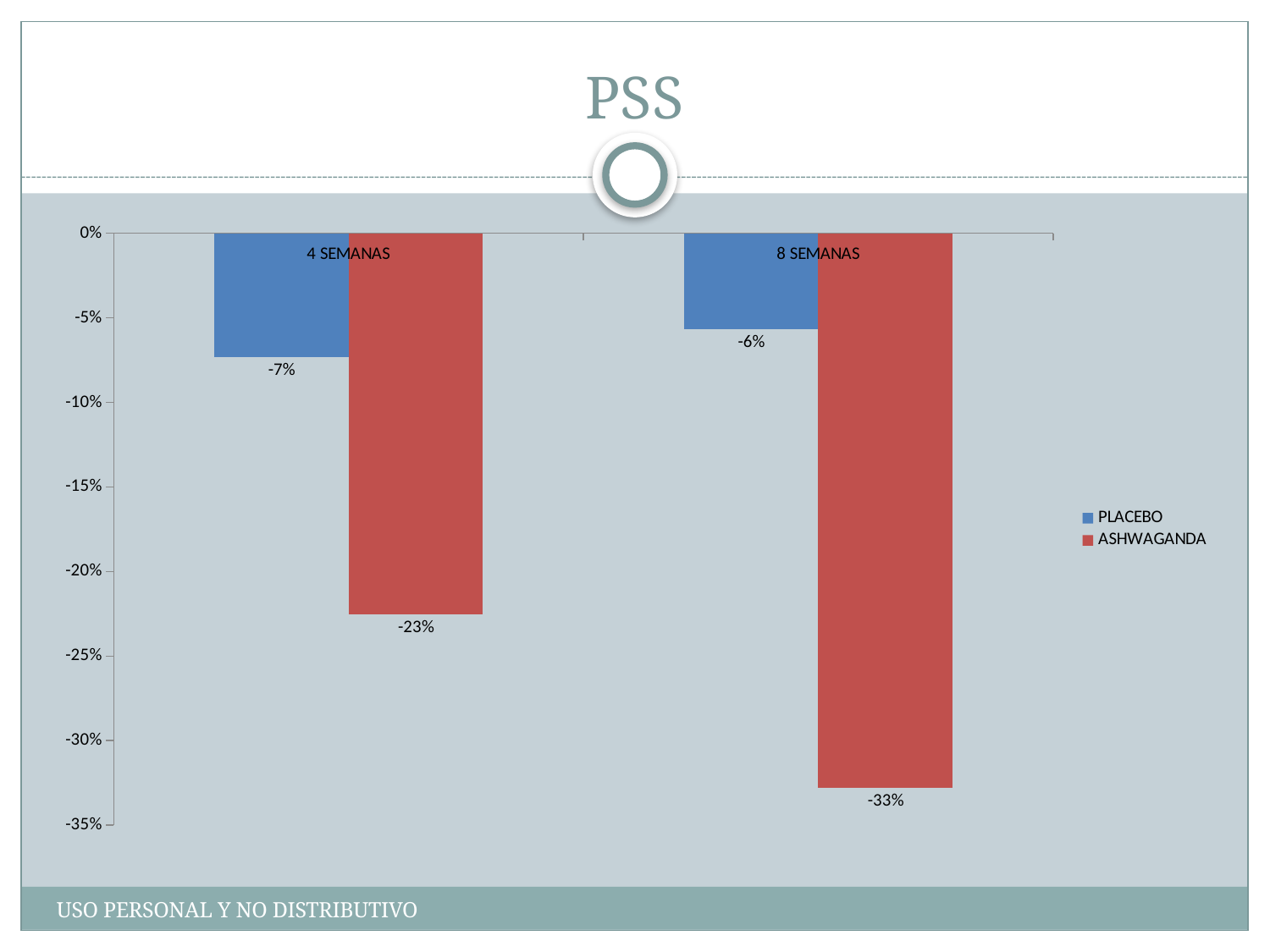
Which bar has the highest value on the chart? PLACEBO at 8 SEMANAS What is the title of the chart? PSS What kind of chart is shown on the slide? Bar chart What is the value for PLACEBO at 8 SEMANAS? -6% How many categories are shown on the x axis? 2 What is the difference between the ASHWAGANDA values at 8 SEMANAS and 4 SEMANAS? 10% What is the value for ASHWAGANDA at 4 SEMANAS? -23% What is the value for ASHWAGANDA at 8 SEMANAS? -33% What is the value for PLACEBO at 4 SEMANAS? -7% Which is larger, the PLACEBO value at 4 SEMANAS or the PLACEBO value at 8 SEMANAS? PLACEBO at 8 SEMANAS Which series has the lowest value at 8 SEMANAS? ASHWAGANDA How many series does the legend list? 2